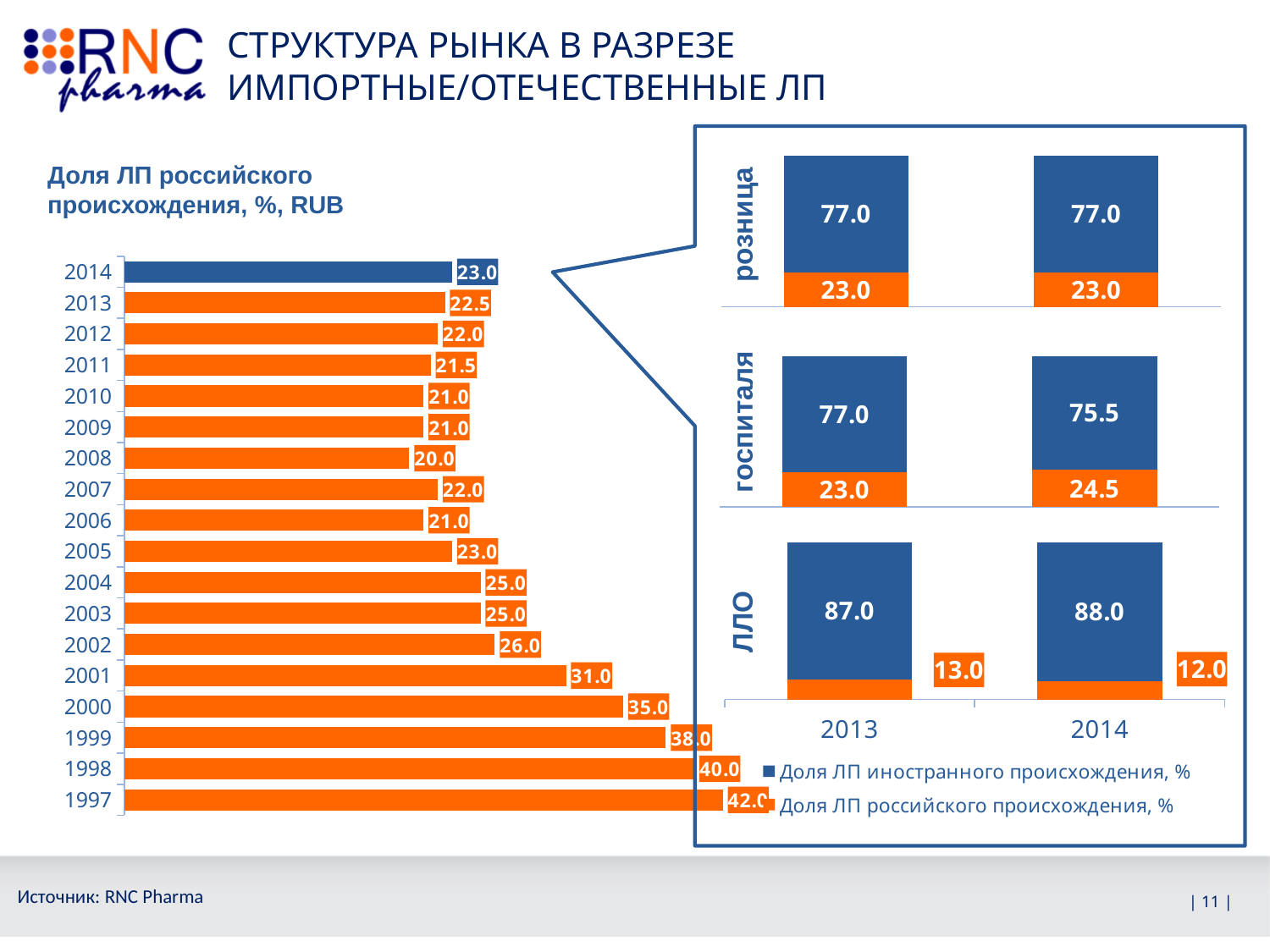
In the right-hand 'госпиталя' chart, what is the value of 'Доля ЛП иностранного происхождения, %' for 2014? 75.5 In the right-hand 'ЛЛО' chart, which is larger: the foreign share in 2013 or in 2014? 2014 In the left chart 'Доля ЛП российского происхождения, %, RUB', do the values generally rise or fall from 1997 to 2008? fall In the left chart 'Доля ЛП российского происхождения, %, RUB', how many years are shown? 18 In the left chart 'Доля ЛП российского происхождения, %, RUB', what is the value for 2001? 31.0 In the left chart 'Доля ЛП российского происхождения, %, RUB', what is the value for 2014? 23.0 In the left chart 'Доля ЛП российского происхождения, %, RUB', which year has the highest value? 1997 What kind of chart is the left chart 'Доля ЛП российского происхождения, %, RUB'? bar chart How many series does the legend of the right-hand stacked charts list? 2 In the right-hand 'ЛЛО' chart, what is the value of 'Доля ЛП российского происхождения, %' for 2013? 13.0 In the left chart 'Доля ЛП российского происхождения, %, RUB', what is the difference between the values for 1998 and 2014? 17.0 In the left chart 'Доля ЛП российского происхождения, %, RUB', which year has the lowest value? 2008